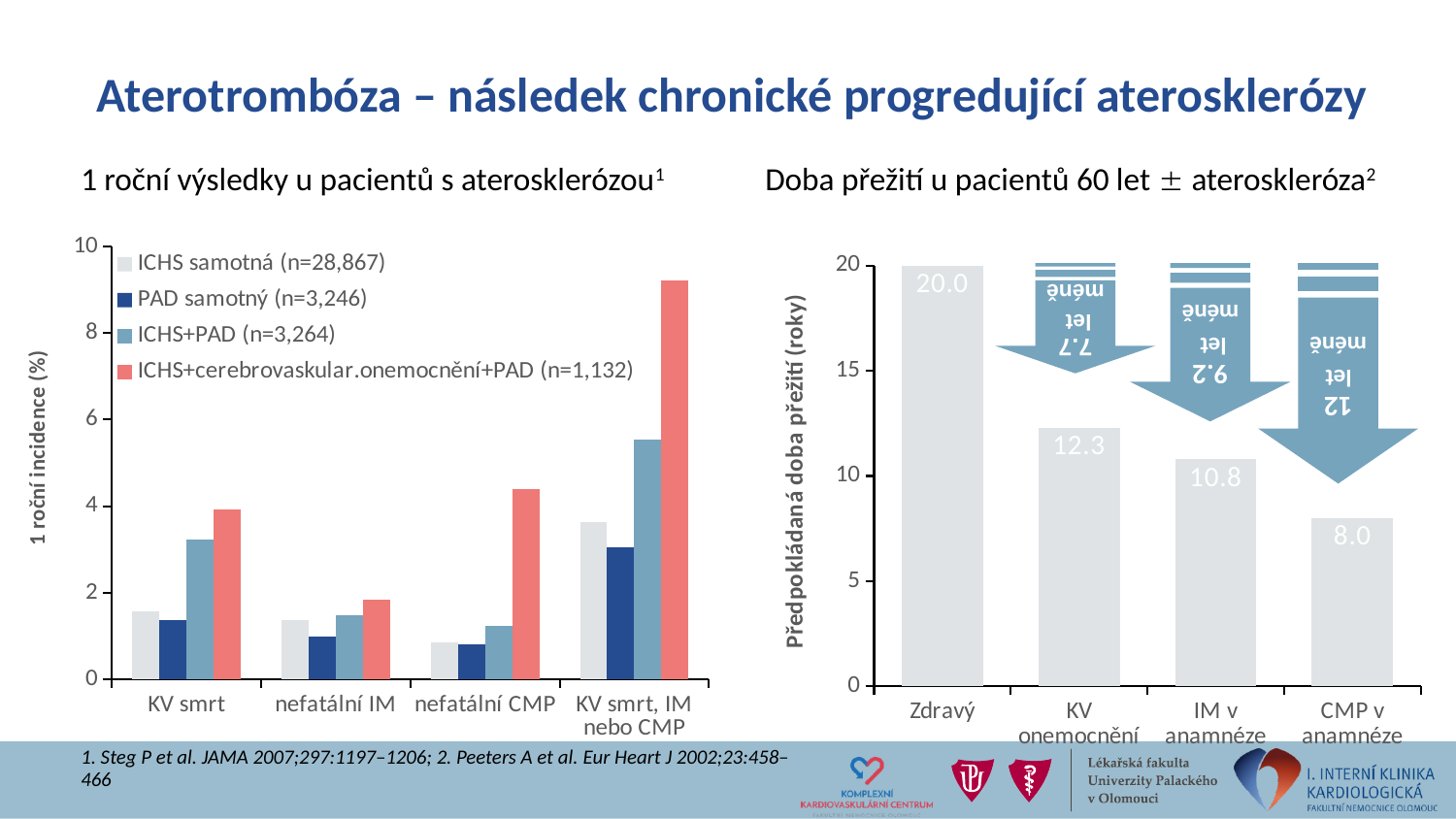
In the right chart (Doba přežití u pacientů 60 let ± ateroskleróza), which category has the lowest value? CMP v anamnéze In the right chart (Doba přežití u pacientů 60 let ± ateroskleróza), what is the value for Zdravý? 20.0 In the right chart (Doba přežití u pacientů 60 let ± ateroskleróza), which is larger: the value for KV onemocnění or the value for IM v anamnéze? KV onemocnění In the right chart (Doba přežití u pacientů 60 let ± ateroskleróza), what is the value for IM v anamnéze? 10.8 In the right chart (Doba přežití u pacientů 60 let ± ateroskleróza), what is the difference between the values for Zdravý and CMP v anamnéze? 12.0 In the left chart (1 roční výsledky u pacientů s aterosklerózou), for which category is the ICHS+cerebrovaskular.onemocnění+PAD series highest? KV smrt, IM nebo CMP In the left chart (1 roční výsledky u pacientů s aterosklerózou), how many series does the legend list? 4 In the right chart (Doba přežití u pacientů 60 let ± ateroskleróza), do the values rise or fall from left to right along the x axis? fall In the right chart (Doba přežití u pacientů 60 let ± ateroskleróza), how many categories are shown on the x axis? 4 In the left chart (1 roční výsledky u pacientů s aterosklerózou), is the value of ICHS+cerebrovaskular.onemocnění+PAD for KV smrt, IM nebo CMP greater or less than 8? greater In the left chart (1 roční výsledky u pacientů s aterosklerózou), what kind of chart is it? bar chart In the left chart (1 roční výsledky u pacientů s aterosklerózou), is the value of ICHS samotná for KV smrt greater or less than 2? less